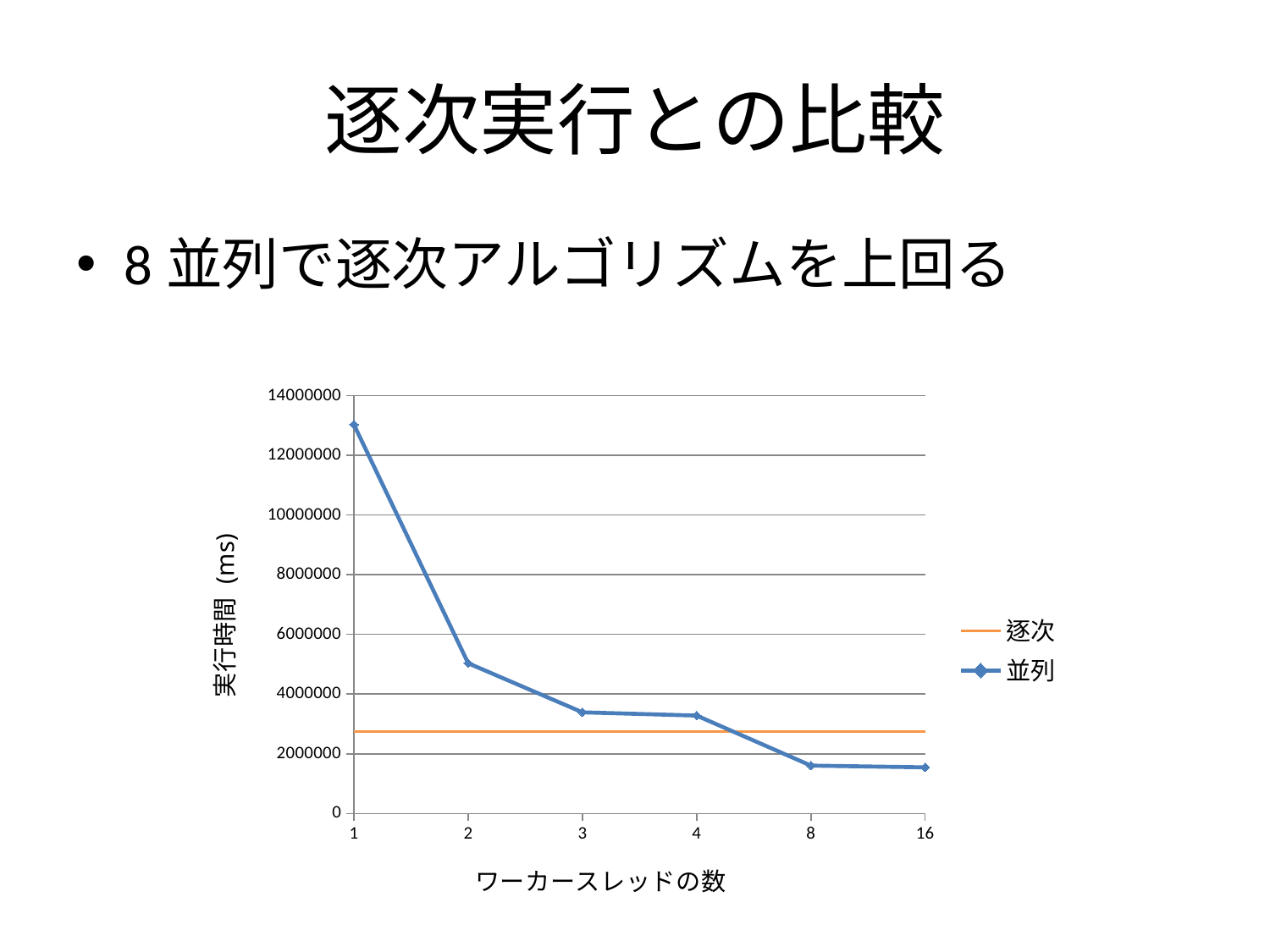
How many worker-thread counts are plotted along the x axis? 6 Is the 並列 value at 8 worker threads greater or less than 2000000? less Is the 並列 value at 1 worker thread greater or less than 12000000? greater Is the 逐次 value greater or less than 4000000? less What kind of chart is shown on the slide? line chart What is the label of the x axis? ワーカースレッドの数 What is the label of the y axis? 実行時間 (ms) At which number of worker threads is the 並列 execution time highest? 1 How many series does the legend list? 2 Does the 並列 series rise or fall as the number of worker threads increases? fall Which is larger at 4 worker threads, the 並列 value or the 逐次 value? 並列